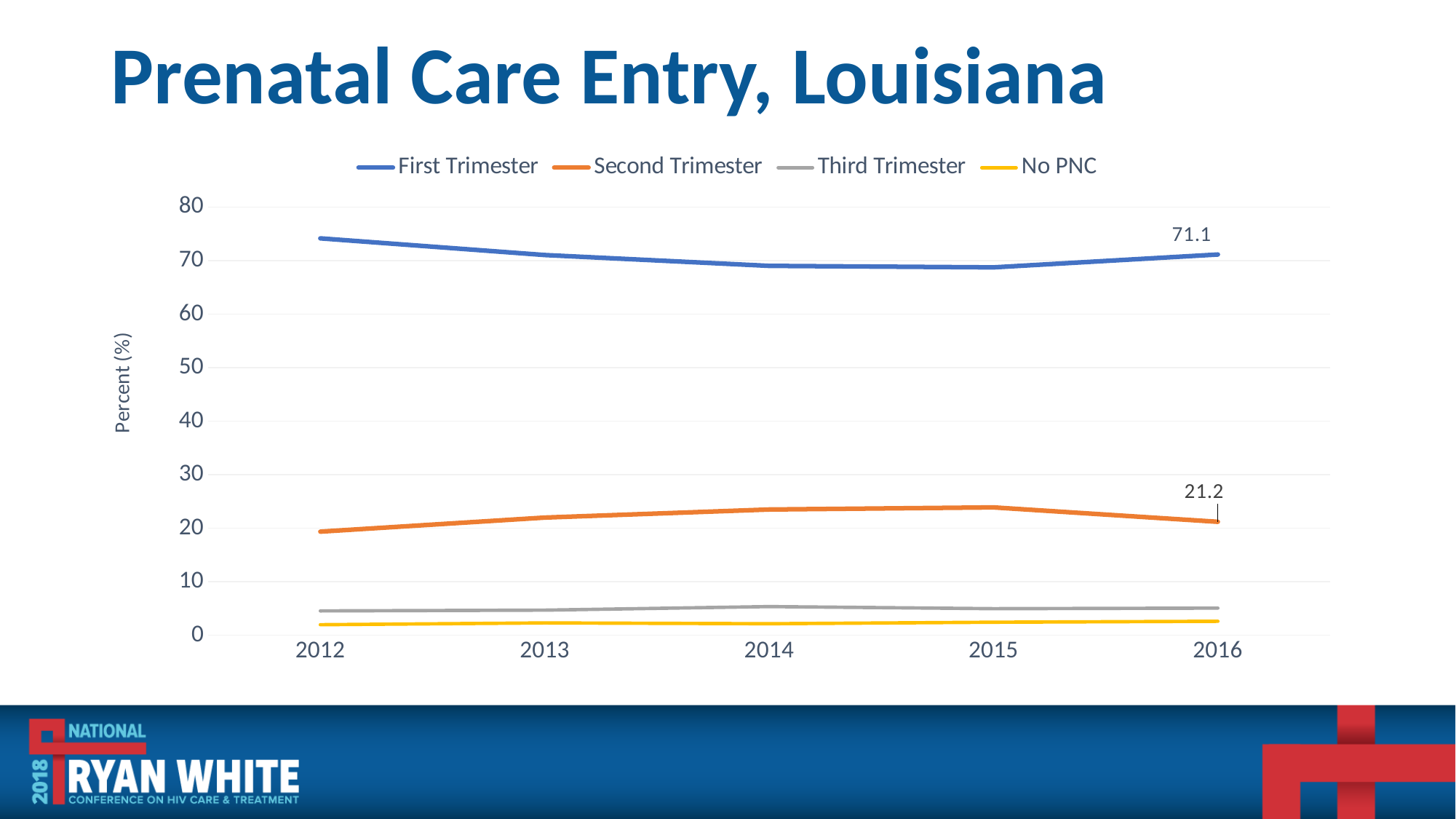
How many series does the legend list? 4 What is the value for Second Trimester in 2016? 21.2 Is the value for Third Trimester in 2014 greater or less than 10? less Which is larger in 2015, the Second Trimester value or the Third Trimester value? Second Trimester What is the value for First Trimester in 2016? 71.1 What is the difference between the First Trimester and Second Trimester values in 2016? 49.9 Which series has the lowest values across all years? No PNC Is the value for First Trimester in 2012 greater or less than 70? greater How many years are shown on the x axis? 5 What kind of chart is shown on the slide? Line chart Which series has the highest values across all years? First Trimester